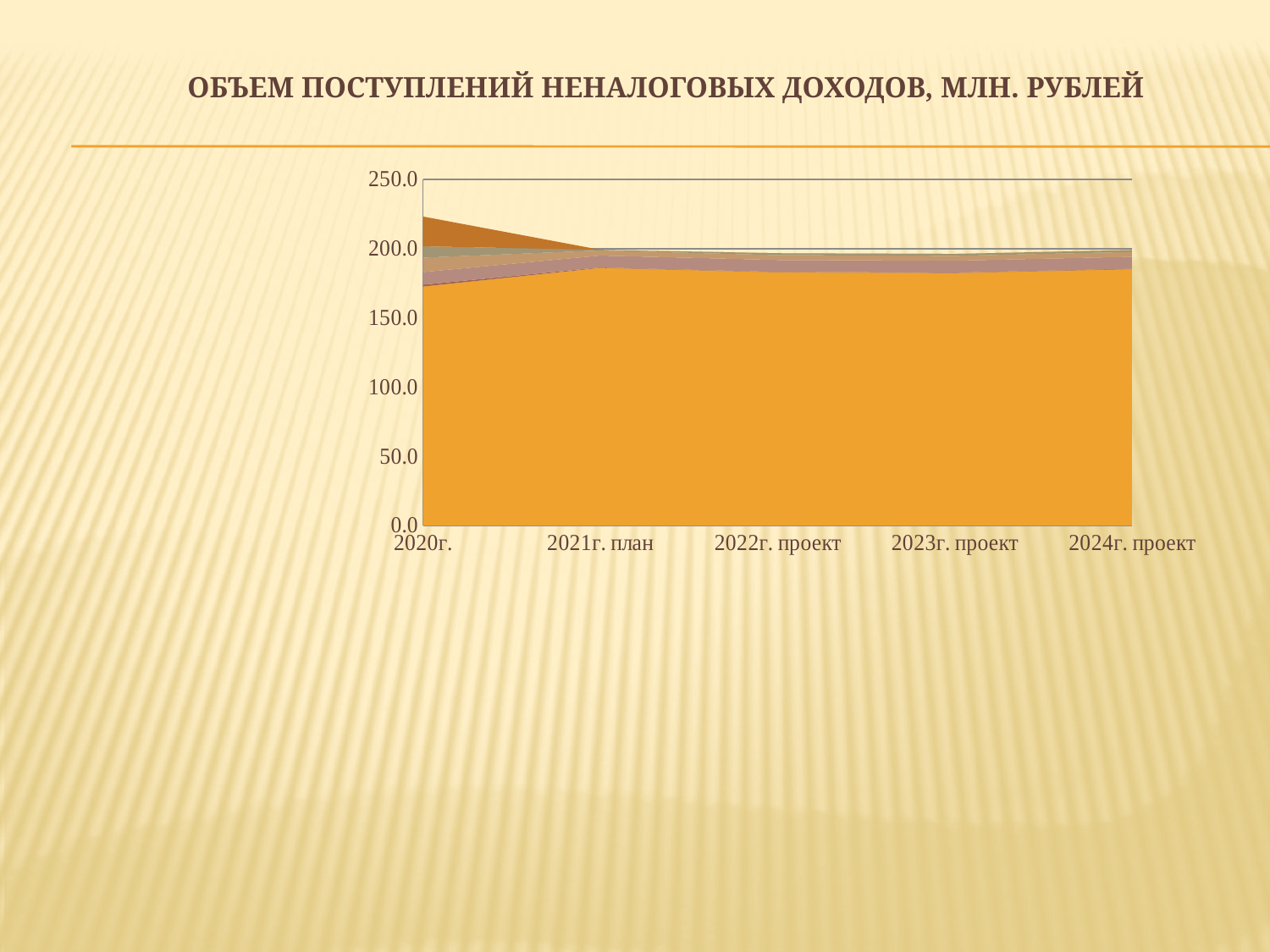
Which has the larger total stacked value, 2020г. or 2024г. проект? 2020г. How many categories (years) are shown along the x axis? 5 Is the value of the bottom (orange) area for 2020г. greater or less than 200? less Is the total stacked value for 2022г. проект greater or less than 250? less Is the value of the bottom (orange) area for 2021г. план greater or less than 150? greater What kind of chart is shown on the slide? Stacked area chart Which category has the highest total stacked value? 2020г. What is the highest value labelled on the y axis? 250.0 Does the total stacked value rise or fall from 2020г. to 2021г. план? fall What is the title of the slide? ОБЪЕМ ПОСТУПЛЕНИЙ НЕНАЛОГОВЫХ ДОХОДОВ, МЛН. РУБЛЕЙ